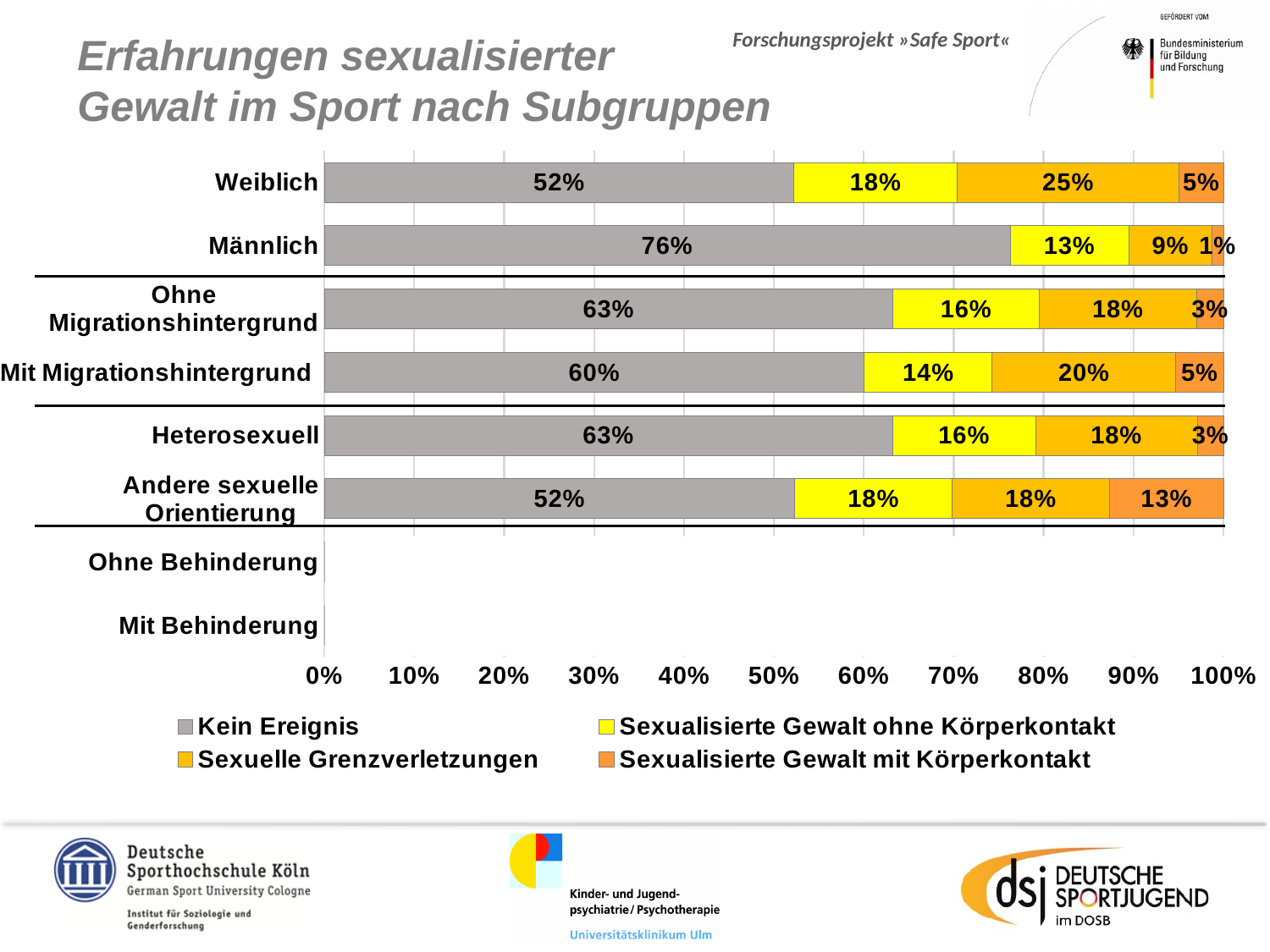
Which is larger: the "Sexuelle Grenzverletzungen" value for Mit Migrationshintergrund or for Ohne Migrationshintergrund? Mit Migrationshintergrund What is the "Sexualisierte Gewalt mit Körperkontakt" value for Andere sexuelle Orientierung? 13% Which subgroup has the highest "Kein Ereignis" value? Männlich Which subgroup has the lowest "Sexualisierte Gewalt mit Körperkontakt" value? Männlich How many series does the legend list? 4 What is the "Sexuelle Grenzverletzungen" value for Weiblich? 25% What is the "Kein Ereignis" value for Männlich? 76% What is the "Sexualisierte Gewalt ohne Körperkontakt" value for Mit Migrationshintergrund? 14% What kind of chart is shown on the slide? Stacked bar chart Which legend entry is shown in grey? Kein Ereignis What is the difference between the "Kein Ereignis" values for Männlich and Weiblich? 24% What is the total of the stacked bar for Heterosexuell? 100%